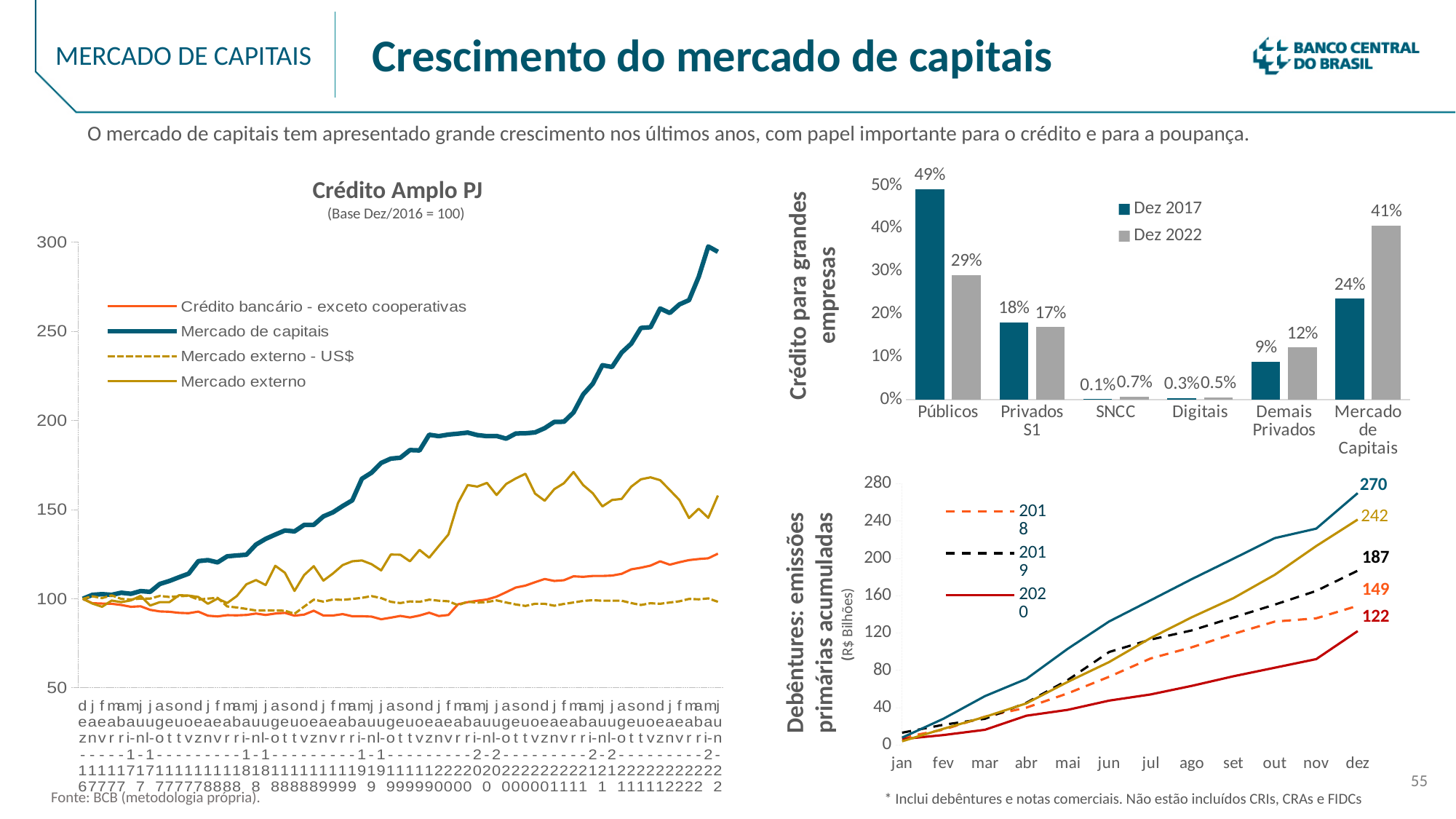
In the 'Crédito para grandes empresas' bar chart, what is the Dez 2022 value for Mercado de Capitais? 41% In the 'Crédito para grandes empresas' bar chart, which category has the lowest Dez 2017 value? SNCC In the 'Crédito para grandes empresas' bar chart, what is the Dez 2017 value for Públicos? 49% In the 'Crédito para grandes empresas' bar chart, which is larger for Demais Privados: Dez 2017 or Dez 2022? Dez 2022 In the 'Crédito Amplo PJ' chart, is the final value of the 'Mercado de capitais' series greater or less than 250? greater What kind of chart is 'Crédito Amplo PJ'? Line chart In the 'Crédito para grandes empresas' bar chart, which category has the highest Dez 2017 value? Públicos In the 'Debêntures: emissões primárias acumuladas' chart, what is the value reached in dez by the 2019 series? 187 How many series does the legend of the 'Crédito Amplo PJ' chart list? 4 In the 'Debêntures: emissões primárias acumuladas' chart, what is the difference between the dez values of the 2018 and 2020 series? 27 In the 'Crédito para grandes empresas' bar chart, what is the difference between the Dez 2017 and Dez 2022 values for Públicos? 20% How many categories are shown on the x axis of the 'Crédito para grandes empresas' bar chart? 6